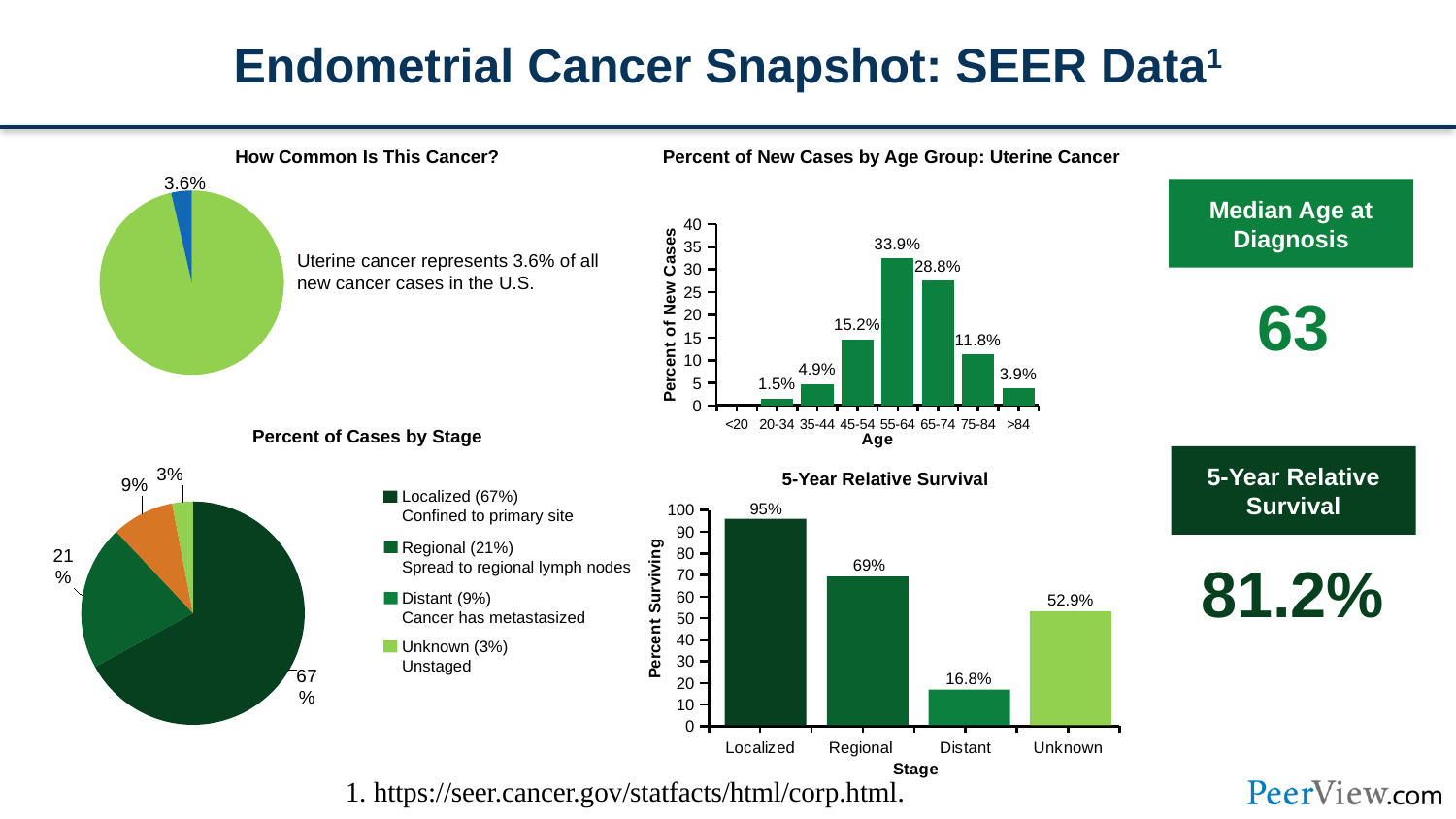
In the 'Percent of New Cases by Age Group: Uterine Cancer' chart, is the value for 45-54 greater or less than 10? greater In the 'Percent of New Cases by Age Group: Uterine Cancer' chart, which age group has the lowest percent of new cases? <20 In the '5-Year Relative Survival' chart, which is larger, the value for Unknown or the value for Distant? Unknown How many age groups are shown in the 'Percent of New Cases by Age Group: Uterine Cancer' chart? 8 In the 'Percent of Cases by Stage' pie chart, what share of cases is Regional? 21% In the '5-Year Relative Survival' chart, which stage has the lowest percent surviving? Distant What kind of chart is the '5-Year Relative Survival' chart? Bar chart In the '5-Year Relative Survival' chart, what is the percent surviving for the Regional stage? 69% In the 'Percent of Cases by Stage' pie chart, which stage has the largest share? Localized In the 'Percent of New Cases by Age Group: Uterine Cancer' chart, what is the difference between the 55-64 and 65-74 age groups? 5.1% In the 'How Common Is This Cancer?' pie chart, what share of all new cancer cases does uterine cancer represent? 3.6% In the 'Percent of New Cases by Age Group: Uterine Cancer' chart, what is the value for the 55-64 age group? 33.9%